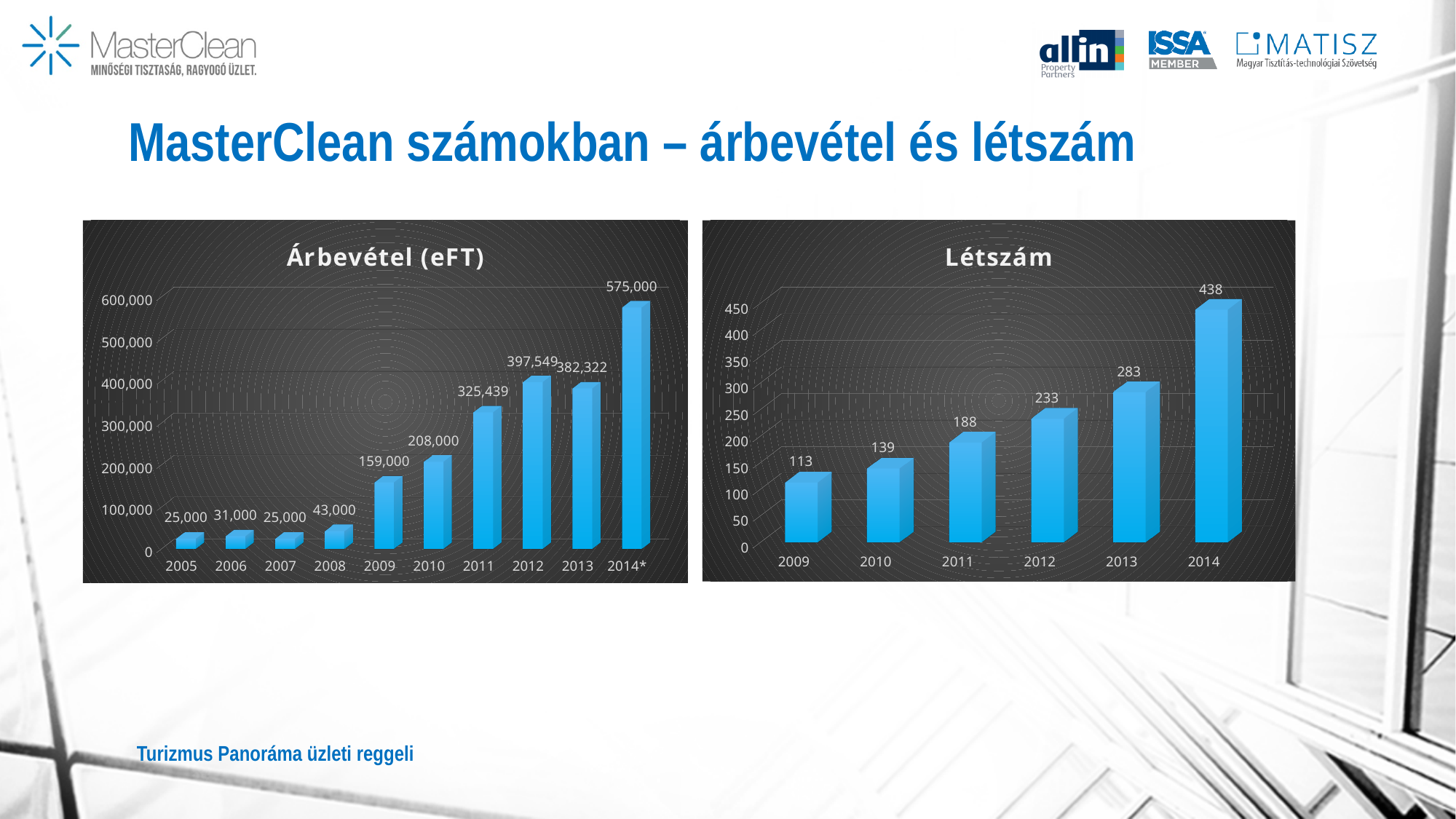
In the 'Árbevétel (eFT)' chart, what is the value for 2014*? 575,000 How many years are shown on the x axis of the 'Árbevétel (eFT)' chart? 10 In the 'Létszám' chart, which year has the highest value? 2014 How many years are shown on the x axis of the 'Létszám' chart? 6 In the 'Árbevétel (eFT)' chart, what is the difference between the 2012 and 2013 values? 15,227 In the 'Árbevétel (eFT)' chart, which is larger, the value for 2012 or the value for 2013? 2012 In the 'Árbevétel (eFT)' chart, which year has the lowest value? 2005 and 2007 (both 25,000) In the 'Létszám' chart, do the values rise or fall from 2009 to 2014? rise In the 'Létszám' chart, what is the difference between the 2014 and 2013 values? 155 In the 'Árbevétel (eFT)' chart, what is the value for 2011? 325,439 What kind of chart is the 'Létszám' chart? bar chart In the 'Létszám' chart, what is the value for 2011? 188